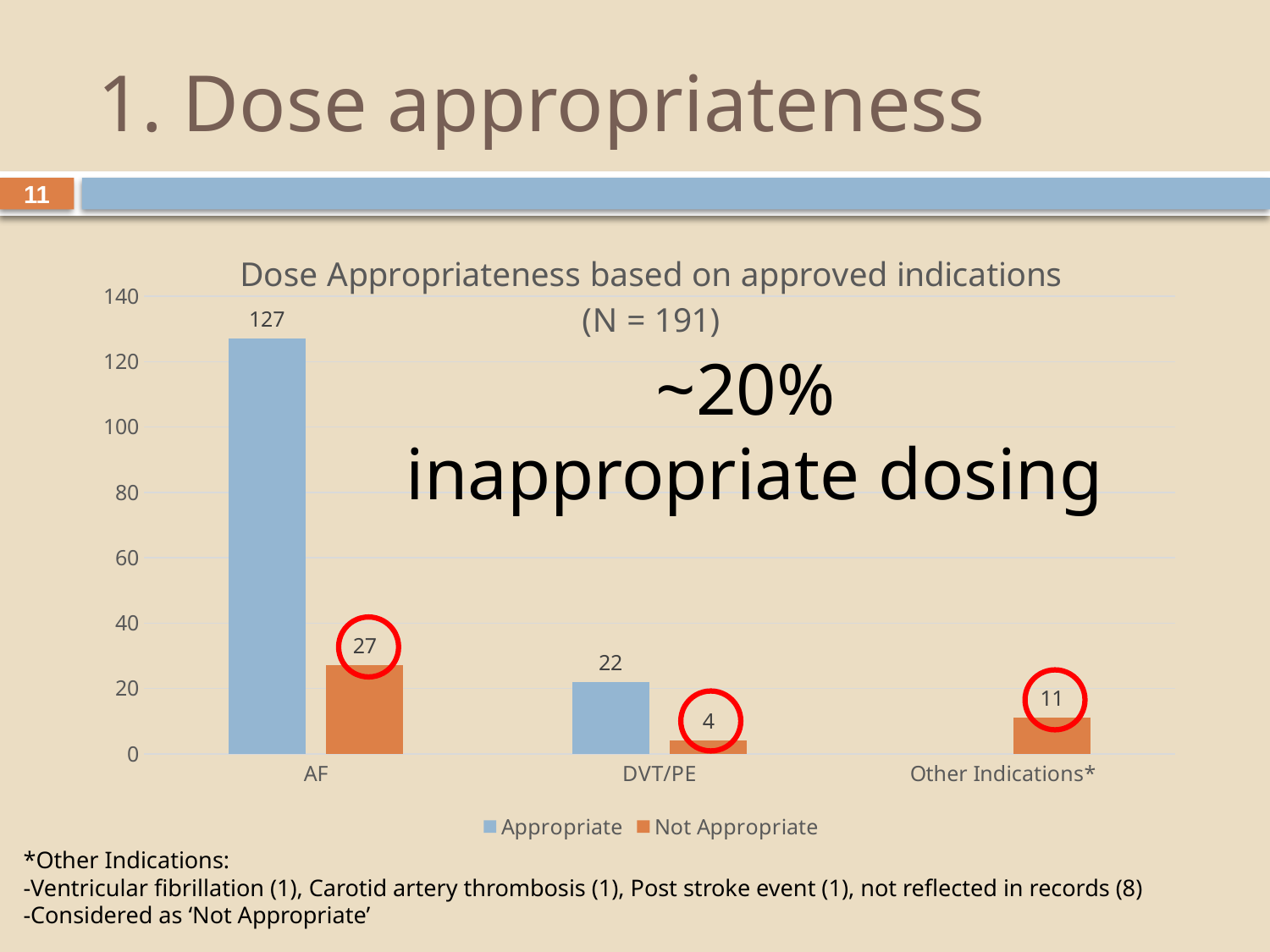
Which is larger for DVT/PE, the Appropriate value or the Not Appropriate value? Appropriate Is the Appropriate value for AF greater or less than 120? greater What kind of chart is shown? bar chart Which category has the lowest Not Appropriate value? DVT/PE How many categories are shown on the x axis? 3 What is the Not Appropriate value for Other Indications*? 11 What is the title of the chart? Dose Appropriateness based on approved indications (N = 191) Which category has the highest Appropriate value? AF What is the Appropriate value for AF? 127 What is the difference between the Appropriate and Not Appropriate values for AF? 100 How many series does the legend list? 2 What is the Not Appropriate value for DVT/PE? 4